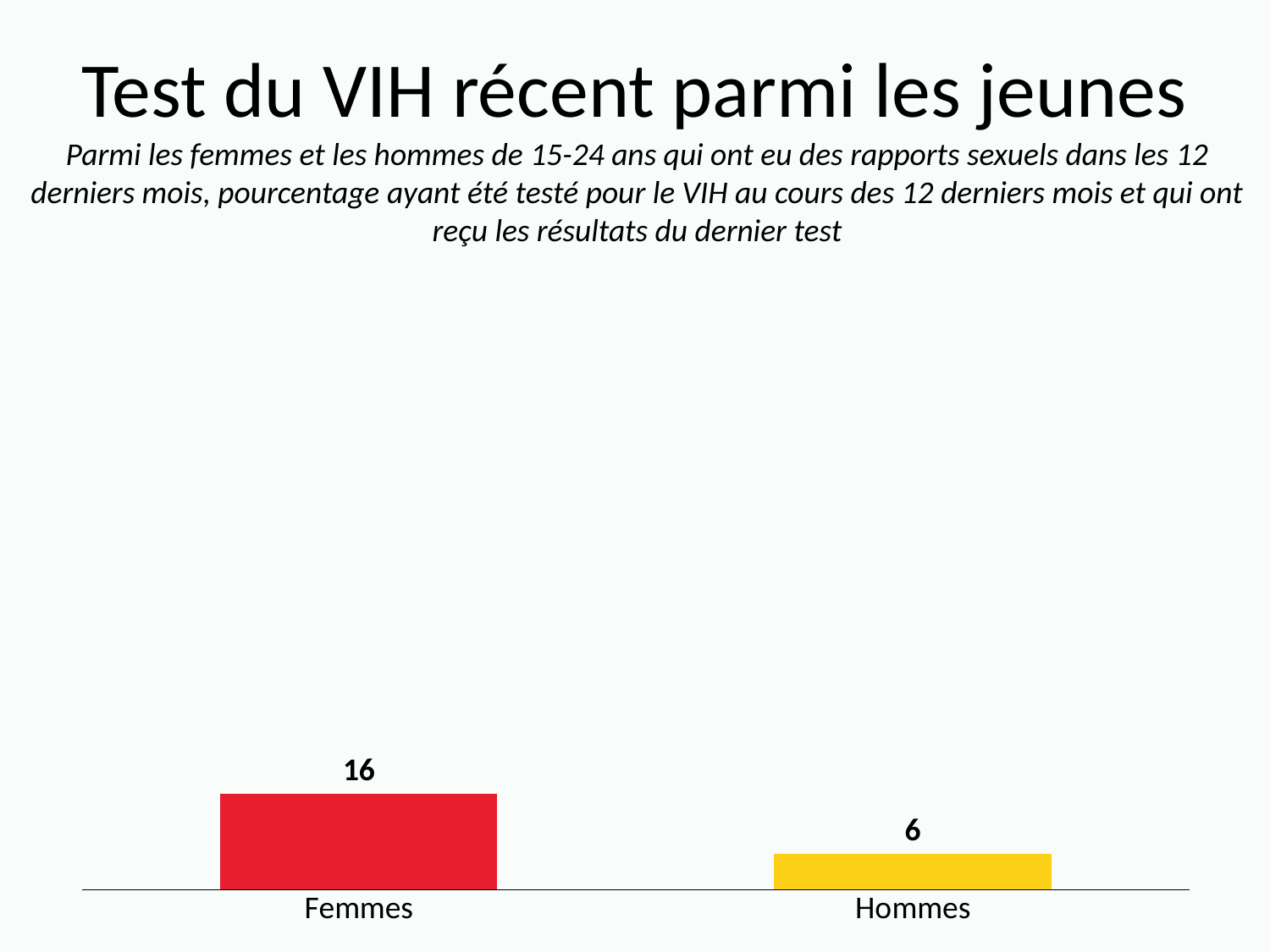
Which category has the highest value? Femmes What is the title of the slide containing the chart? Test du VIH récent parmi les jeunes Which is larger, the value for Femmes or the value for Hommes? Femmes What colour is the bar for Hommes? Yellow What is the value for Femmes? 16 How many categories are shown in the chart? 2 What is the difference between the values for Femmes and Hommes? 10 What is the value for Hommes? 6 Which category has the lowest value? Hommes What kind of chart is shown on the slide? Bar chart